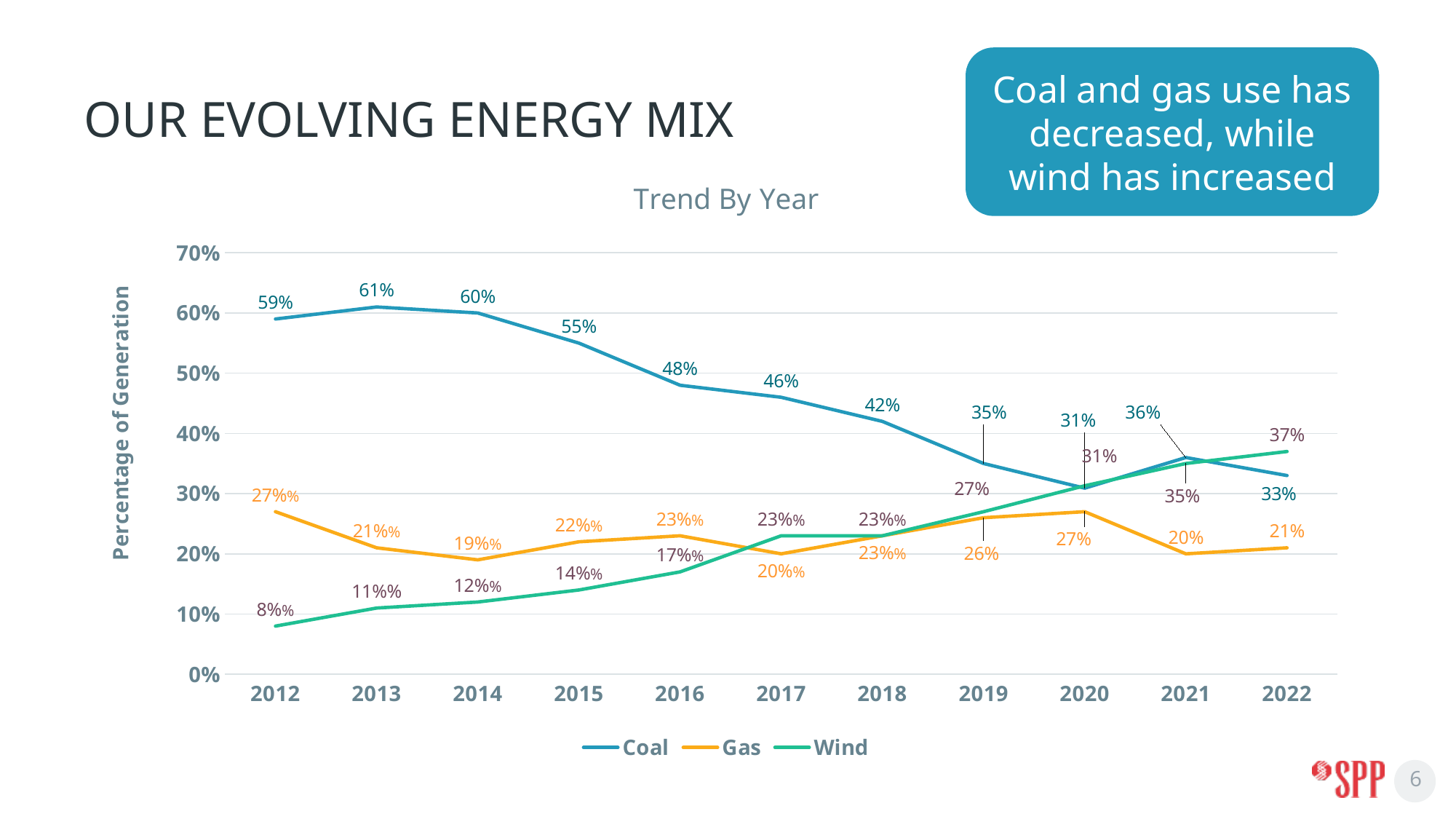
In which year was the Wind value lowest? 2012 What was the Wind percentage of generation in 2022? 37% How many years are plotted along the x axis? 11 What was the Gas percentage of generation in 2020? 27% In which year was the Coal value highest? 2013 Which was larger in 2022, Coal or Wind? Wind What type of chart is shown on the slide? line chart What was the Coal percentage of generation in 2012? 59% What is the difference between the Coal value in 2012 and the Coal value in 2022? 26% How many series does the legend list? 3 Does the Wind series rise or fall from 2012 to 2022? rise What is the title of the chart? Trend By Year